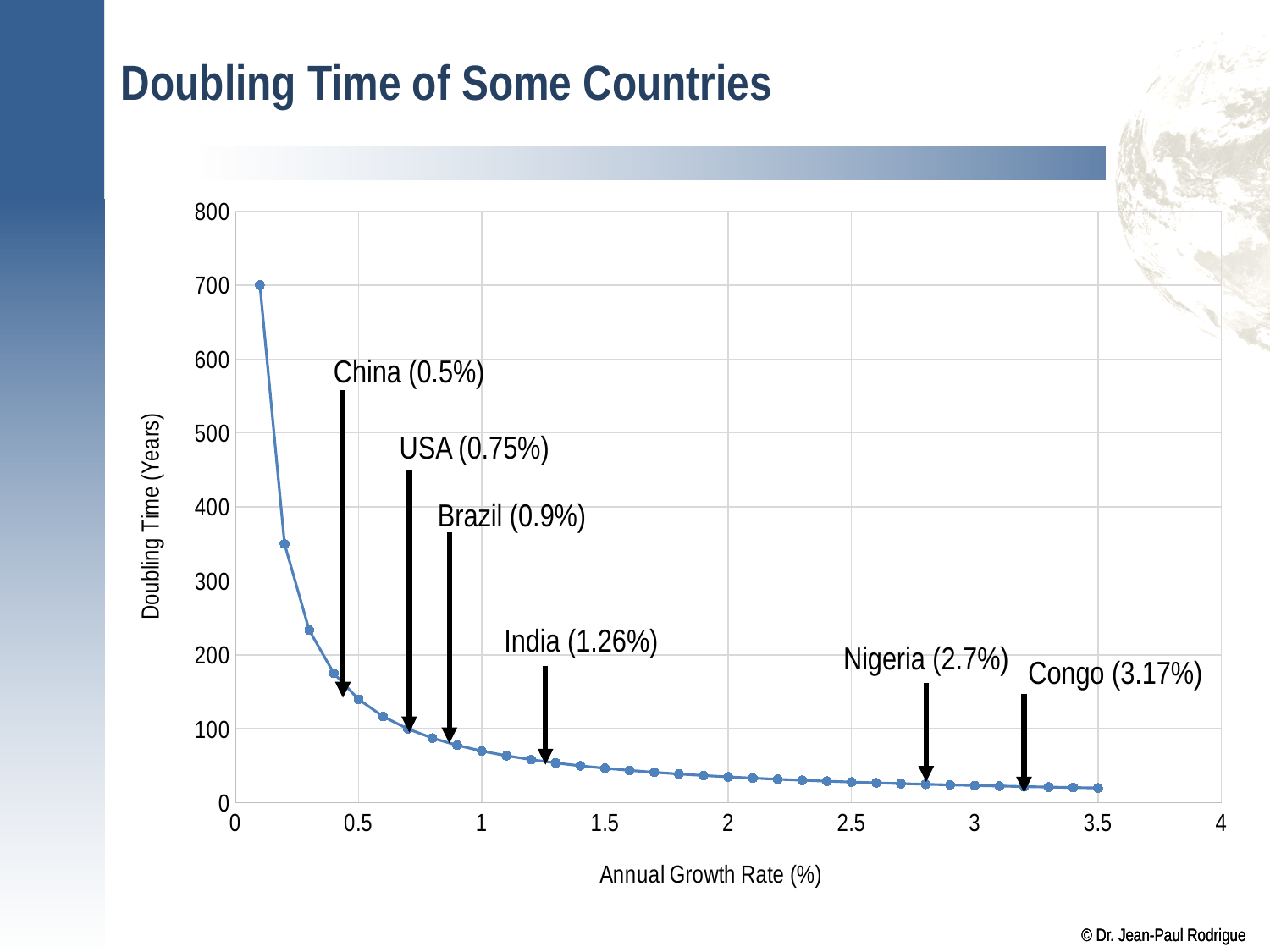
How many countries are annotated on the chart? 6 What is the title of the chart on the slide? Doubling Time of Some Countries Does the doubling time rise or fall as the annual growth rate increases along the x axis? fall Is the doubling time at an annual growth rate of 3.5% greater or less than 100? less Is the doubling time at an annual growth rate of 0.5% greater or less than 200? less Is the doubling time at an annual growth rate of 1% greater or less than 100? less What annual growth rate is shown for Nigeria in the chart annotation? 2.7% What is the doubling time at an annual growth rate of 0.1%? 700 What kind of chart is shown on the slide? line chart Which has the larger doubling time: an annual growth rate of 0.5% or 1%? 0.5%